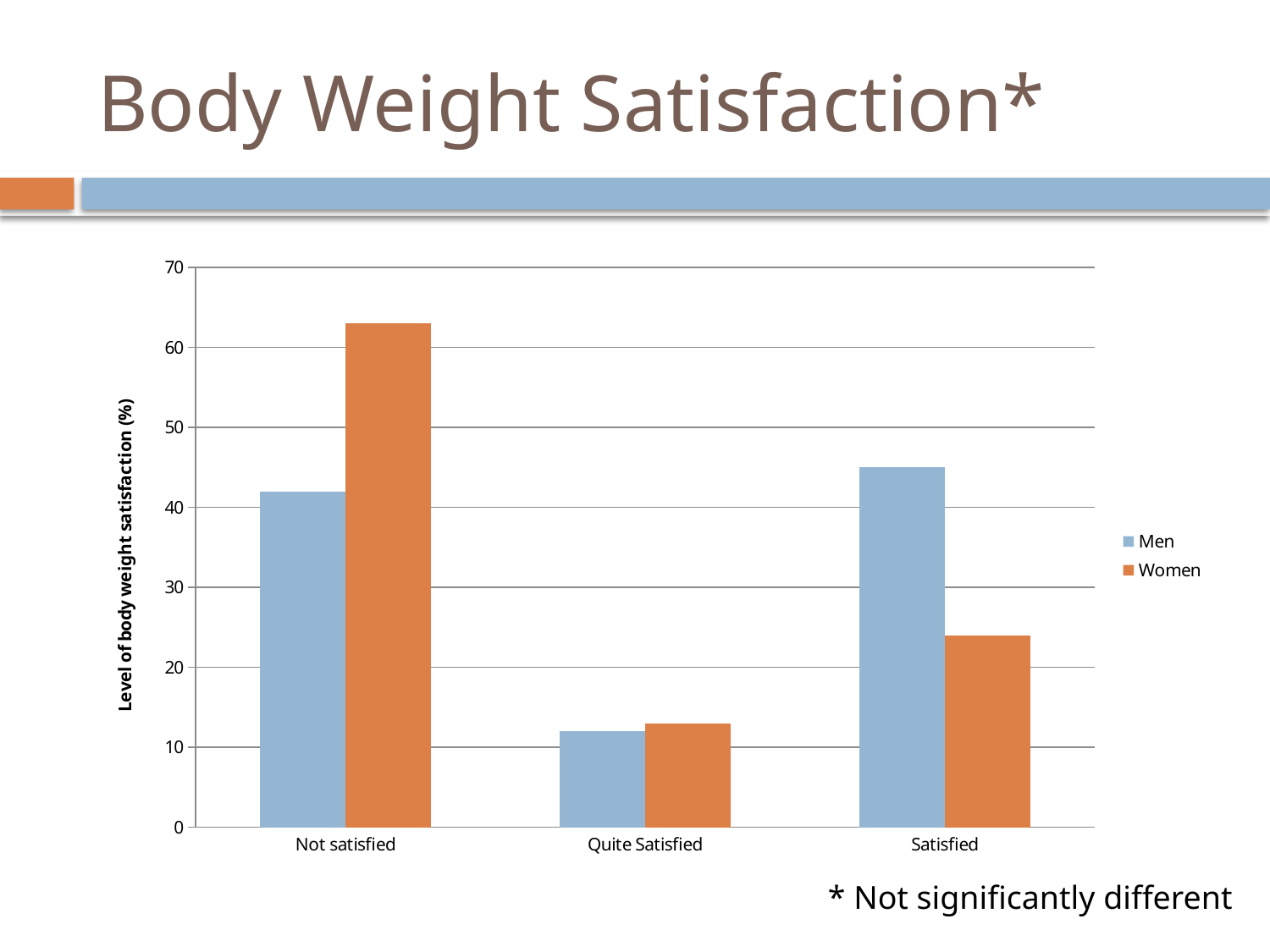
Is the value for Women in the Satisfied category greater or less than 30? less Which category has the highest value for Men? Satisfied Is the value for Men in the Not satisfied category greater or less than 50? less How many series does the legend list? 2 What kind of chart is shown on the slide? bar chart What is the label of the vertical axis? Level of body weight satisfaction (%) How many categories are shown on the x axis? 3 In the Not satisfied category, which series has the larger value, Men or Women? Women Is the value for Women in the Not satisfied category greater or less than 60? greater Which category has the lowest value for Men? Quite Satisfied In the Satisfied category, which series has the larger value, Men or Women? Men Which category has the highest value for Women? Not satisfied